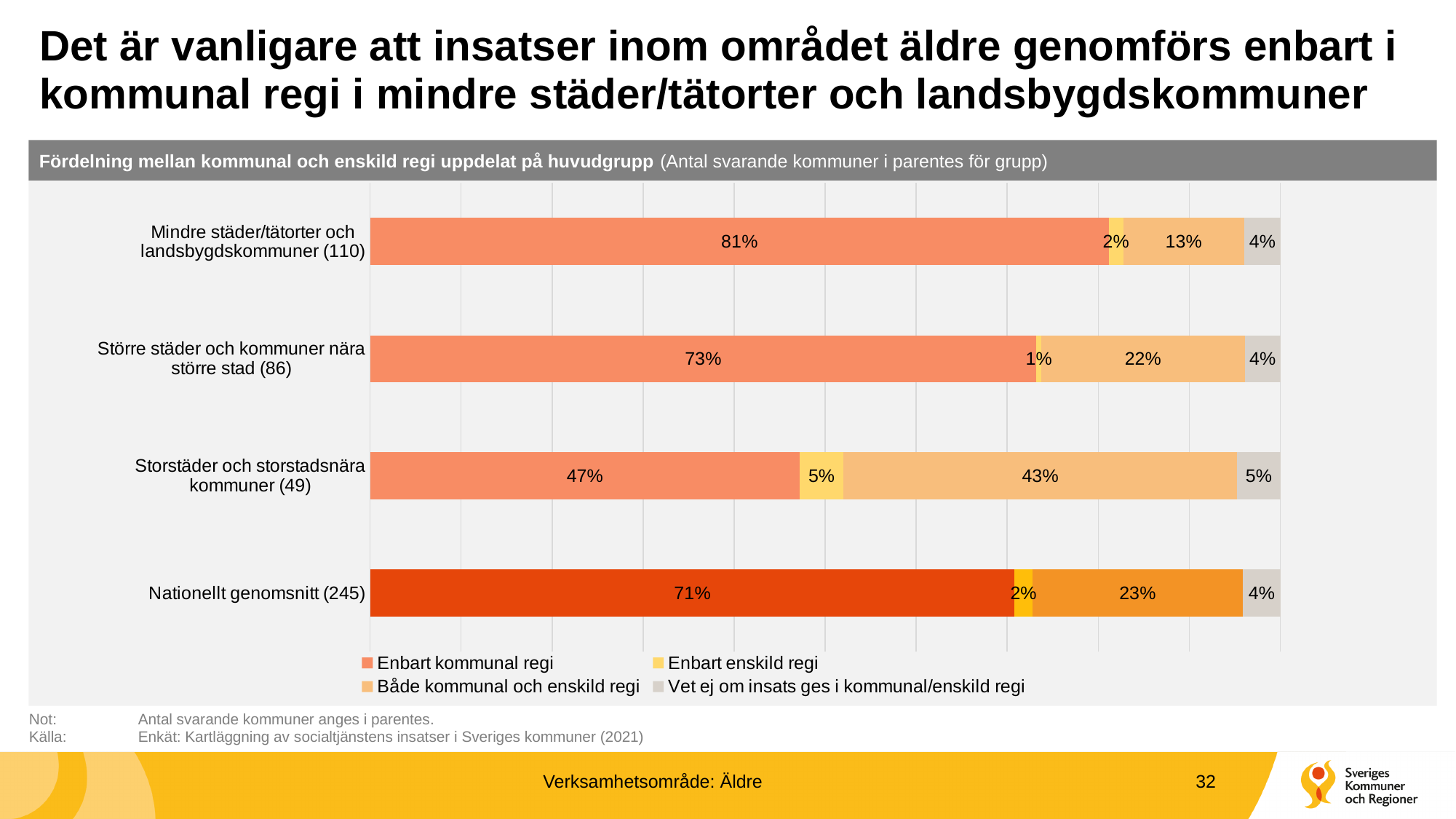
What is the value of "Enbart kommunal regi" for "Mindre städer/tätorter och landsbygdskommuner (110)"? 81% How many categories are shown on the chart? 4 How many series does the legend list? 4 Which category has the highest value for "Enbart kommunal regi"? Mindre städer/tätorter och landsbygdskommuner (110) What is the difference in "Enbart kommunal regi" between "Mindre städer/tätorter och landsbygdskommuner (110)" and "Storstäder och storstadsnära kommuner (49)"? 34 percentage points Which category has the lowest value for "Både kommunal och enskild regi"? Mindre städer/tätorter och landsbygdskommuner (110) What is the value of "Enbart kommunal regi" for "Nationellt genomsnitt (245)"? 71% What is the value of "Enbart enskild regi" for "Större städer och kommuner nära större stad (86)"? 1% Which is larger: "Både kommunal och enskild regi" for "Större städer och kommuner nära större stad (86)" or for "Nationellt genomsnitt (245)"? Nationellt genomsnitt (245) What kind of chart is shown on the slide? Stacked horizontal bar chart What is the value of "Både kommunal och enskild regi" for "Storstäder och storstadsnära kommuner (49)"? 43% What is the value of "Vet ej om insats ges i kommunal/enskild regi" for "Storstäder och storstadsnära kommuner (49)"? 5%